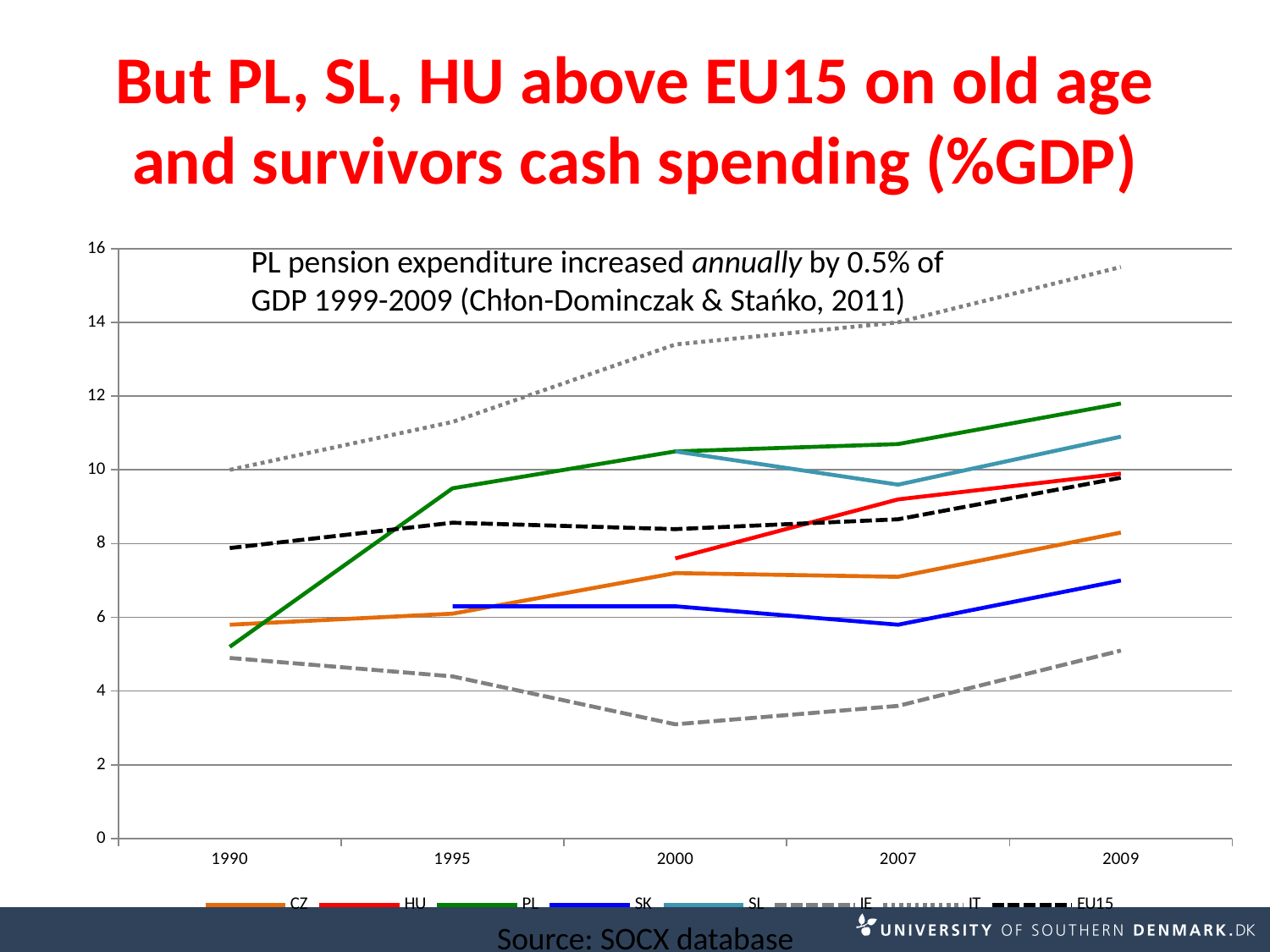
How many years are labelled on the x axis? 5 Is the value for PL in 1990 greater or less than 6? less Which series has the lowest value in 1990? IE Which is larger in 2009, PL or EU15? PL Does the IT series rise or fall from 1990 to 2009? rise Which series has the highest value in 2009? IT Which series has the lowest value in 2009? IE Is the value for IT in 2009 greater or less than 14? greater How many series does the legend list? 8 Is the value for IE in 2000 greater or less than 4? less What kind of chart is shown on the slide? line chart Which is larger in 2007, CZ or SK? CZ